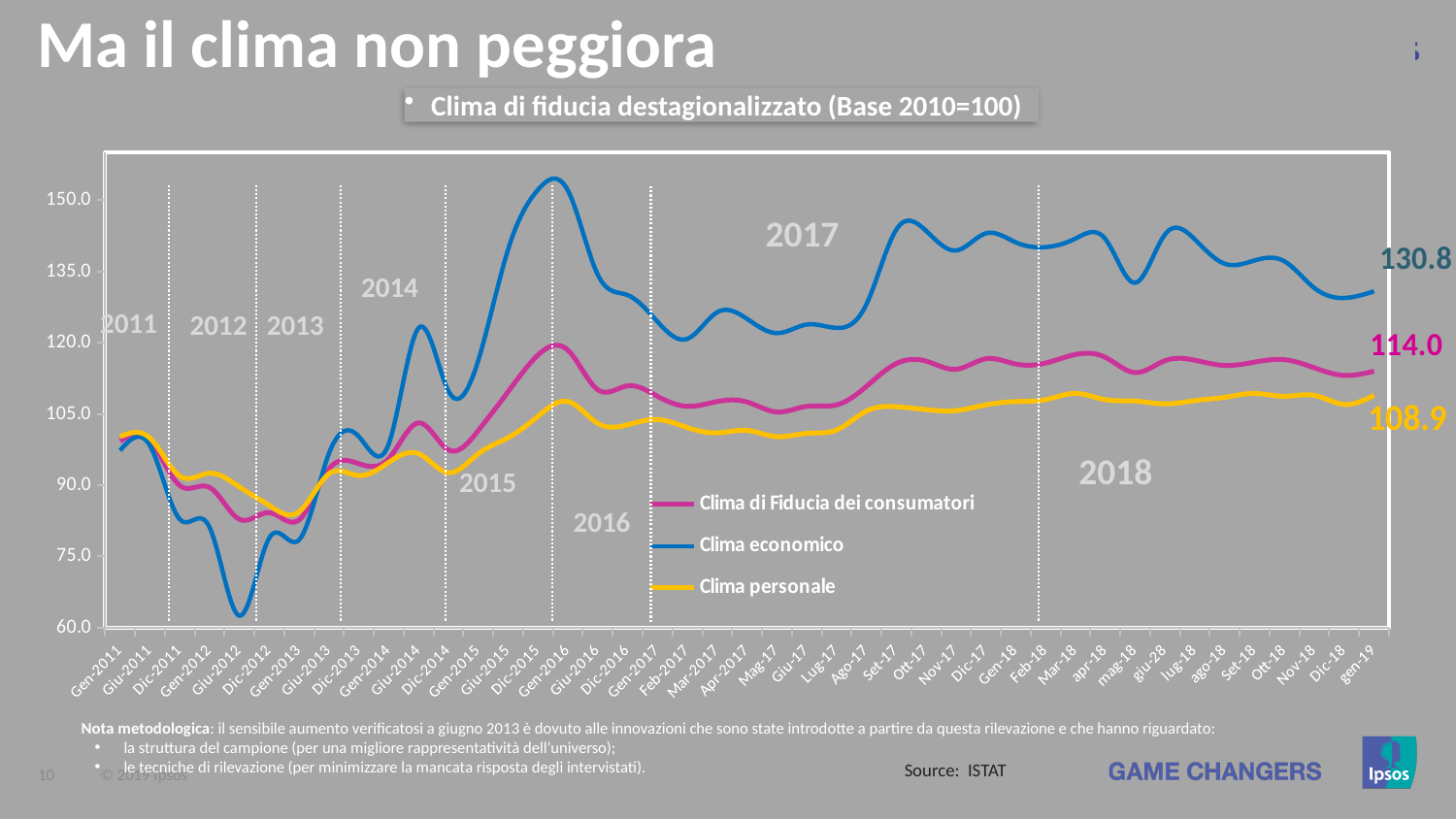
What is the difference between the final values of Clima di Fiducia dei consumatori and Clima personale? 5.1 At gen-19, which is larger: Clima economico or Clima personale? Clima economico Is the value of Clima economico at Dic-2015 greater or less than 150.0? greater Is the value of Clima economico at Giu-2012 greater or less than 75.0? less What is the value of Clima economico at the end of the series (gen-19)? 130.8 What is the value of Clima di Fiducia dei consumatori at the end of the series (gen-19)? 114.0 How many series does the legend list? 3 Which series has the lowest value at gen-19? Clima personale What is the difference between the final values of Clima economico and Clima di Fiducia dei consumatori? 16.8 Which series has the highest value at gen-19? Clima economico What kind of chart is shown on the slide? Line chart What is the value of Clima personale at the end of the series (gen-19)? 108.9